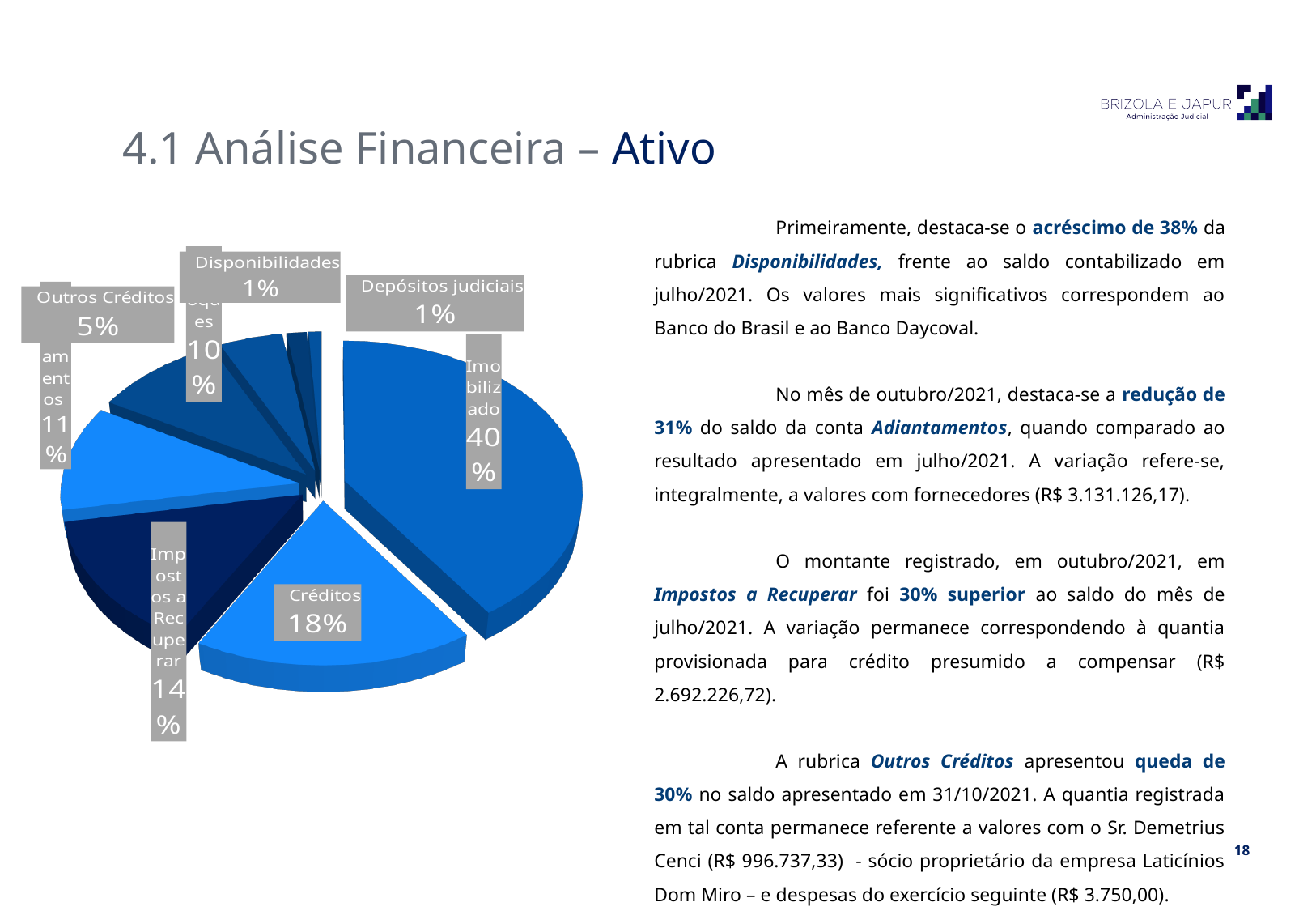
What kind of chart is shown on the slide? pie chart What share of the pie does Imobilizado represent? 40% How many slices does the pie chart have? 8 What percentage is shown for Disponibilidades? 1% What is the title of the slide containing the pie chart? 4.1 Análise Financeira – Ativo What percentage is shown for Outros Créditos? 5% Which is larger, the share for Créditos or the share for Impostos a Recuperar? Créditos What percentage is shown for Depósitos judiciais? 1% What percentage is shown for Impostos a Recuperar? 14% What percentage is shown for Créditos? 18% What is the difference in percentage points between Imobilizado and Créditos? 22 percentage points Which category has the largest slice of the pie? Imobilizado